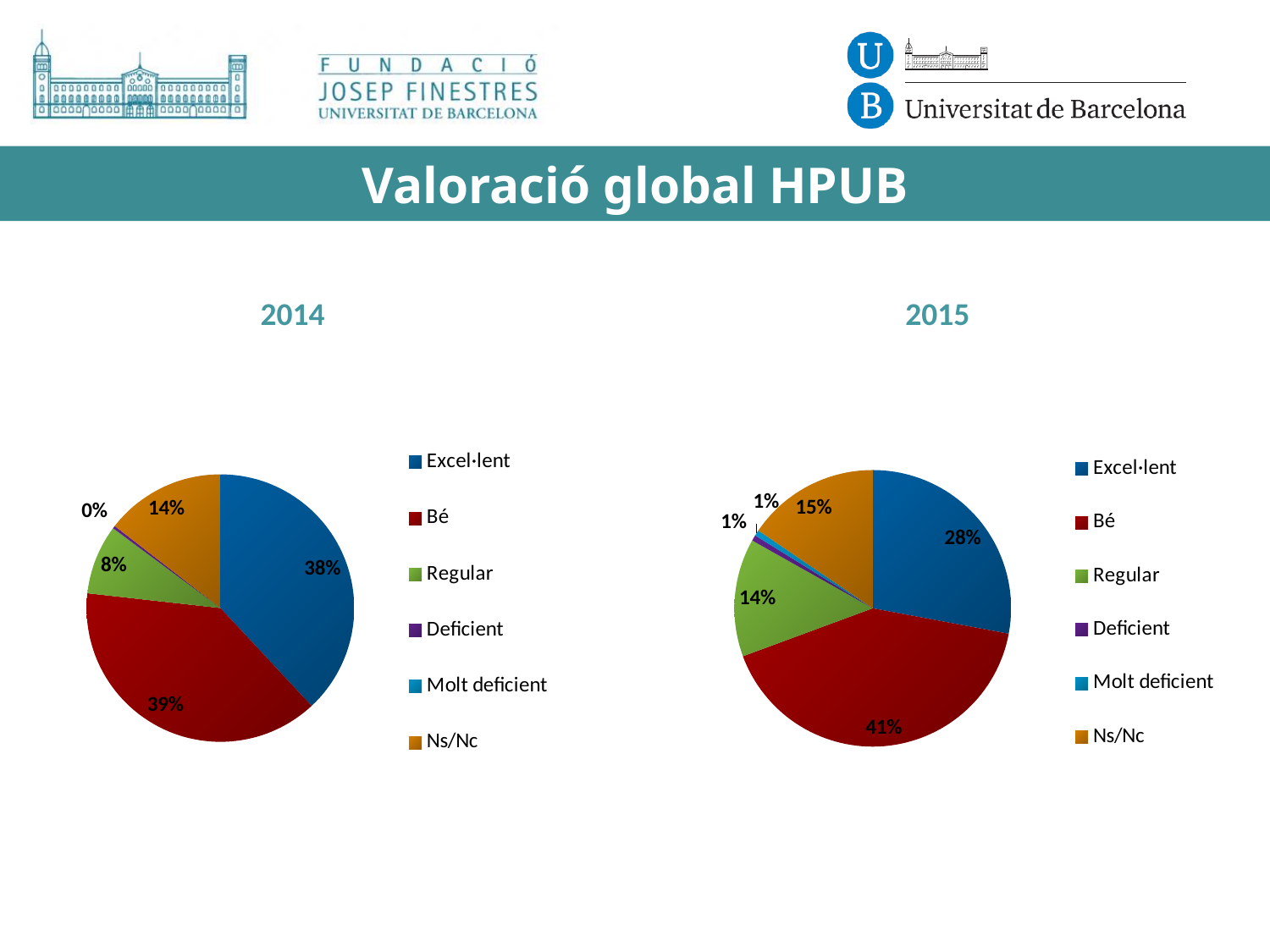
In the 2014 chart, what percentage is shown for Ns/Nc? 14% In the 2015 chart, what percentage is shown for Ns/Nc? 15% In the 2014 chart, what percentage is shown for Excel·lent? 38% In the 2014 chart, what percentage is shown for Bé? 39% What kind of chart is used for the 2014 data? Pie chart In the 2015 chart, what percentage is shown for Bé? 41% In the 2014 chart, what percentage is shown for Regular? 8% How many entries does the legend of the 2015 chart list? 6 In the 2015 chart, what percentage is shown for Excel·lent? 28% In the 2014 chart, which is larger, Regular or Ns/Nc? Ns/Nc In the 2015 chart, what is the difference between the Bé and Excel·lent percentages? 13% In the 2015 chart, which category has the largest slice? Bé